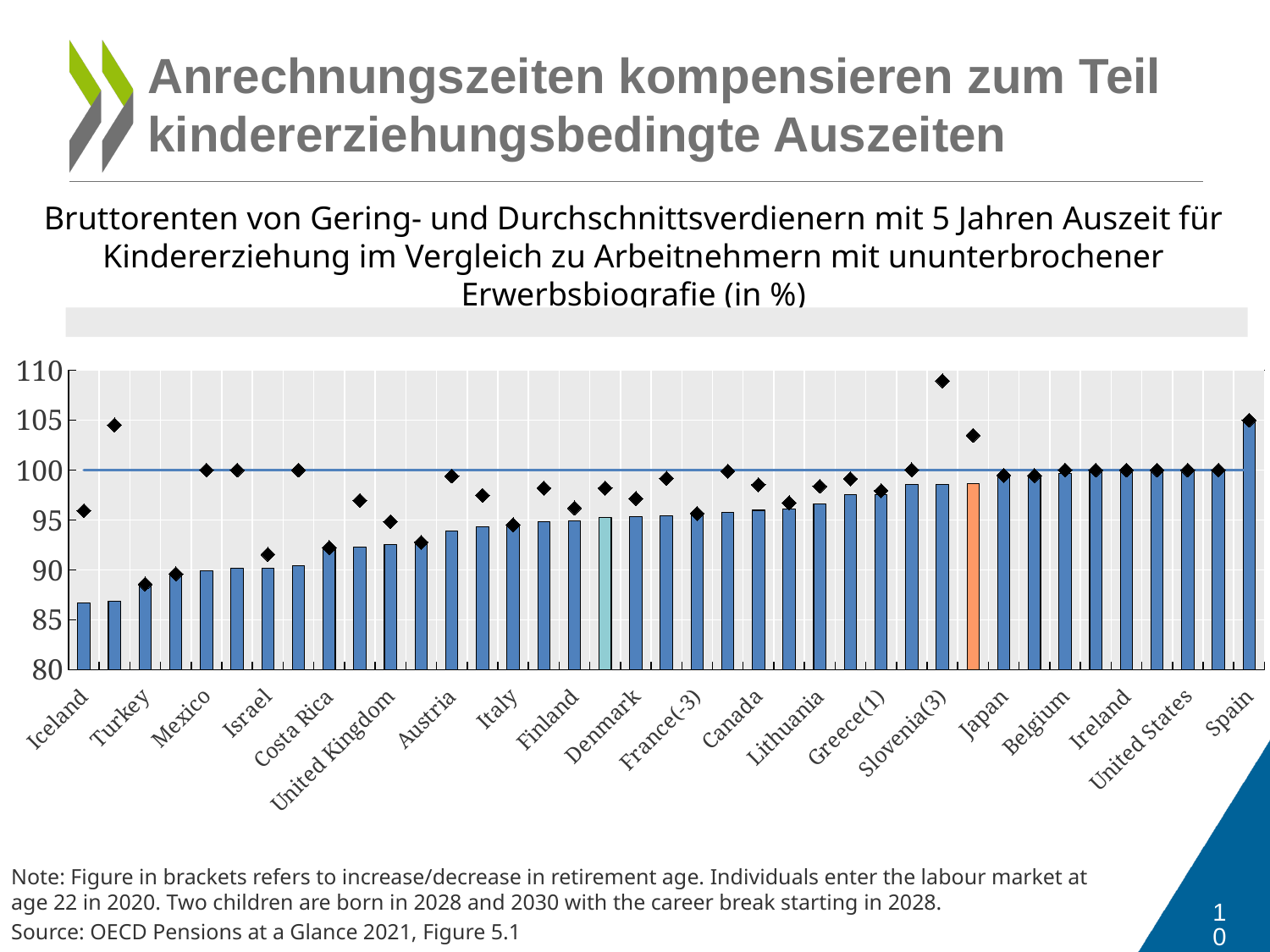
Do the bar values generally rise or fall from left to right along the x axis? rise Which has the taller bar, Iceland or Spain? Spain Is the bar value for Spain greater or less than 100? greater Which has the taller bar, Austria or Canada? Canada What kind of chart is shown on the slide? combination bar and line chart Is the bar value for Slovenia(3) greater or less than 100? less Is the diamond marker value for Turkey greater or less than 100? less At what value is the horizontal reference line drawn across the chart? 100 Which country has the highest bar in the chart? Spain